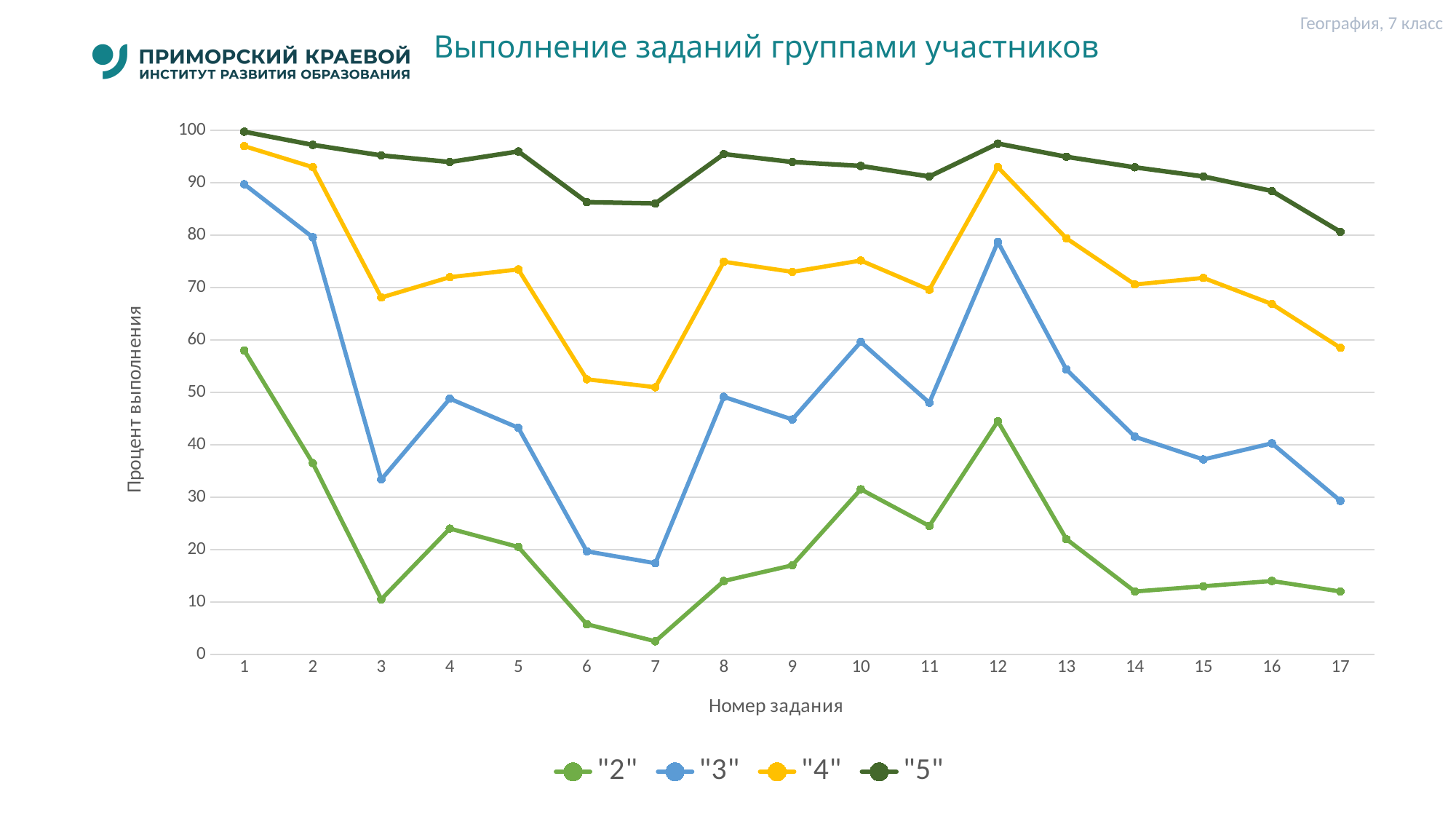
How many series does the legend list? 4 What kind of chart is shown on the slide? line chart For series "2", which task number has the highest value? 1 For series "5", which task number has the lowest value? 17 What is the title of the chart? Выполнение заданий группами участников For series "2", which task number has the lowest value? 7 Is the value for series "2" at task 3 greater or less than 20? less Do the values for series "5" rise or fall from task 12 to task 17? fall At task 7, which series has the larger value, "4" or "3"? "4" Is the value for series "5" at task 6 greater or less than 90? less How many tasks (points along the x axis) are plotted? 17 Is the value for series "3" at task 1 greater or less than 80? greater